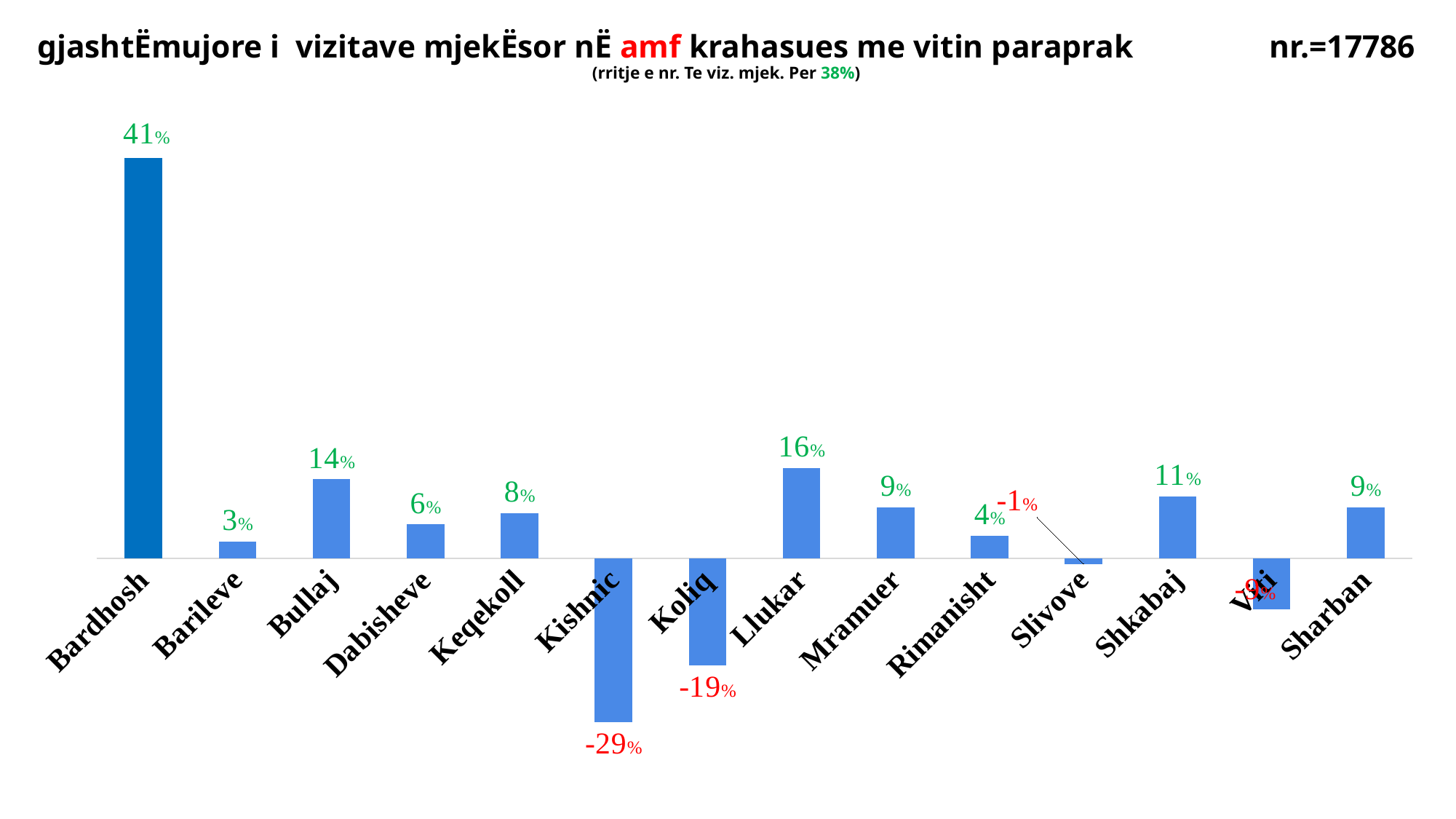
What kind of chart is shown on the slide? Bar chart What is the value for Bardhosh? 41% What is the value for Rimanisht? 4% How many categories are shown on the x axis? 14 What is the difference between the values for Koliq and Kishnic? 10% What is the value for Slivove? -1% What is the difference between the values for Bullaj and Barileve? 11% Which category has the lowest value? Kishnic What is the value for Llukar? 16% What is the value for Kishnic? -29% Which is larger, the value for Shkabaj or the value for Keqekoll? Shkabaj Which category has the highest value? Bardhosh